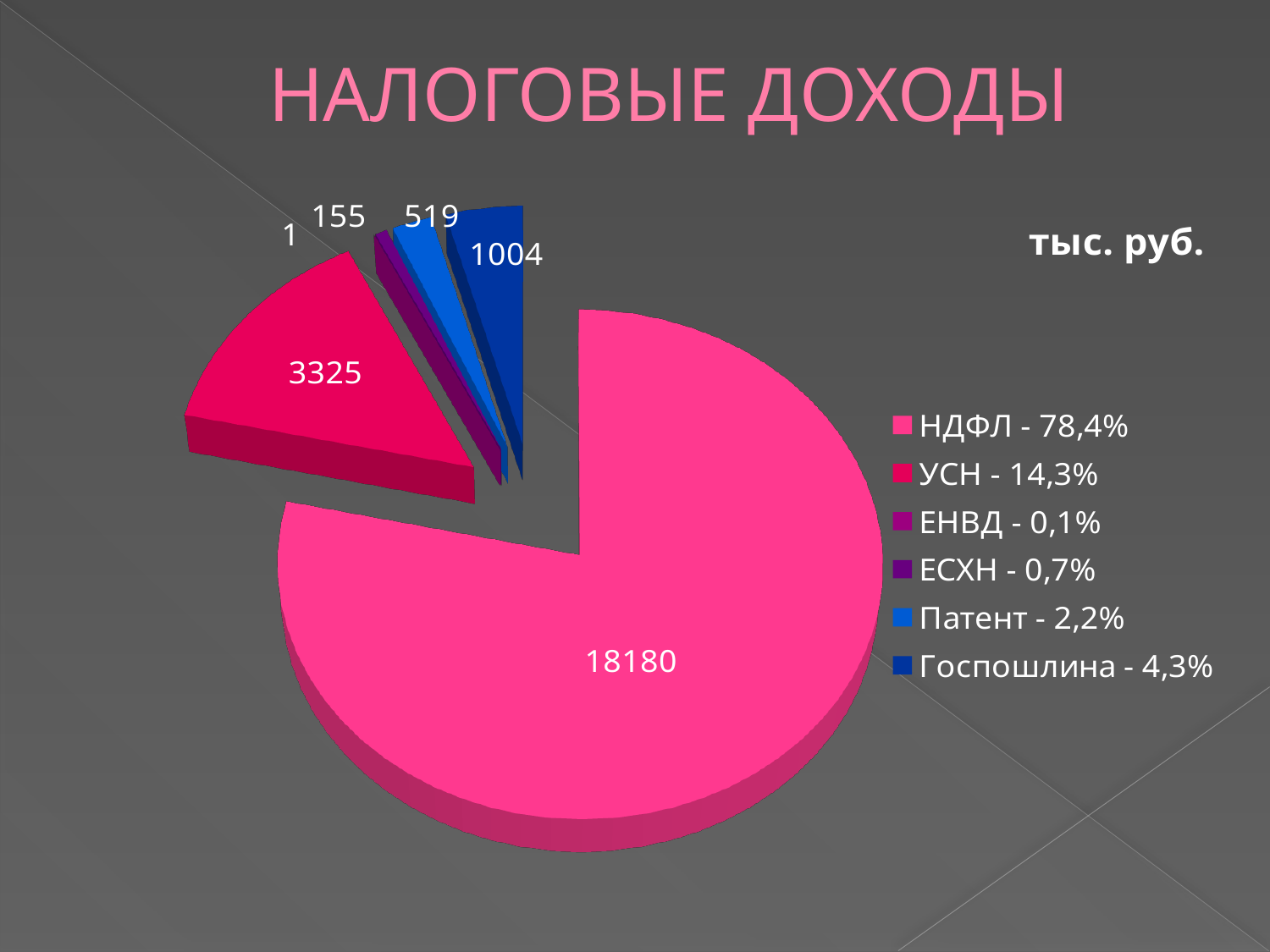
What is the value shown for the УСН slice? 3325 Which category has the smallest share of the pie? ЕНВД What is the value shown for the Патент slice? 519 What kind of chart is shown on the slide? pie chart What is the value shown for the Госпошлина slice? 1004 Which category has the largest slice of the pie? НДФЛ How many categories does the legend list? 6 What share of the pie does НДФЛ account for, according to the legend? 78,4% What is the title of the chart? НАЛОГОВЫЕ ДОХОДЫ What is the value shown for the ЕСХН slice? 155 What is the value shown for the НДФЛ slice? 18180 What is the difference between the НДФЛ value and the УСН value? 14855